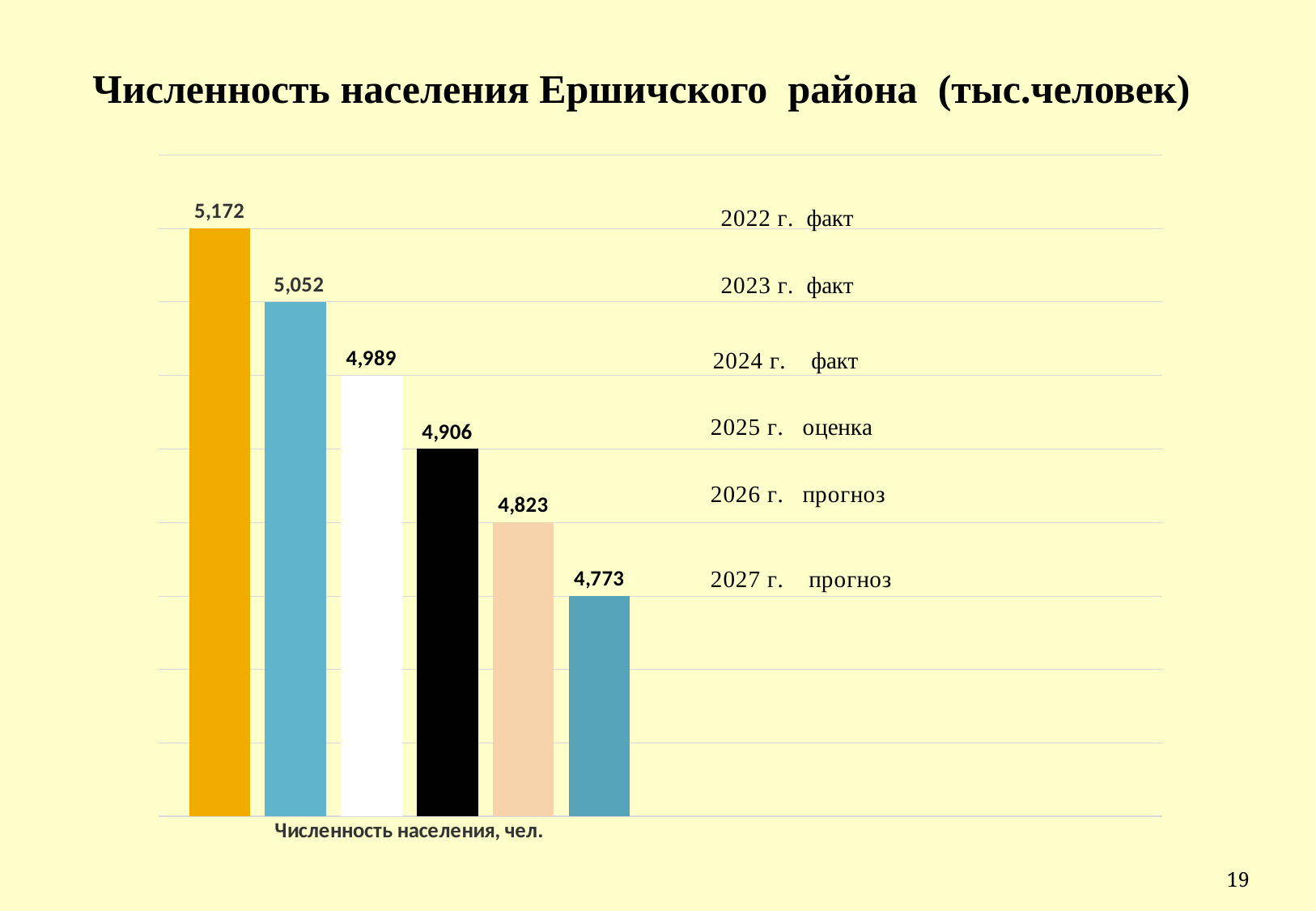
What type of chart is shown on the slide? Bar chart Do the values rise or fall from 2022 to 2027? Fall Which is larger, the value for 2025 or the value for 2026? 2025 What is the population value shown for 2027 (прогноз)? 4,773 What is the population value shown for 2025 (оценка)? 4,906 How many bars are plotted on the chart? 6 What is the difference between the 2023 value and the 2024 value? 63 Which year has the highest population value on the chart? 2022 What is the population value shown for 2024 (факт)? 4,989 What is the difference between the 2022 value and the 2027 value? 399 What is the population value shown for 2022 (факт)? 5,172 Which year has the lowest population value on the chart? 2027